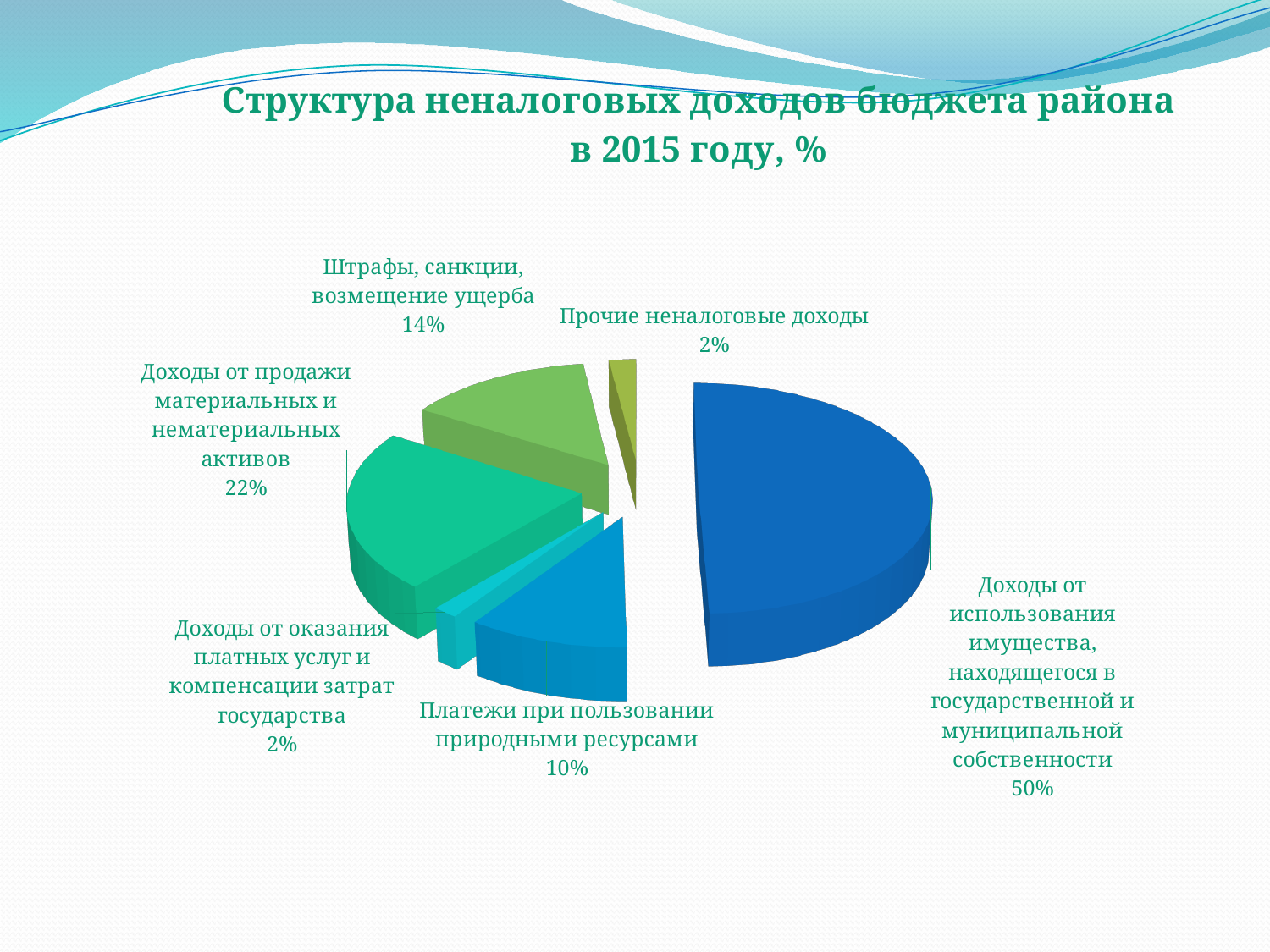
What kind of chart is shown on the slide? Pie chart What share of the pie is labelled "Доходы от использования имущества, находящегося в государственной и муниципальной собственности"? 50% What is the difference between the shares of "Доходы от продажи материальных и нематериальных активов" and "Штрафы, санкции, возмещение ущерба"? 8% What is the title of the chart on the slide? Структура неналоговых доходов бюджета района в 2015 году, % What is the value shown for "Прочие неналоговые доходы"? 2% What is the difference between the largest slice and "Платежи при пользовании природными ресурсами"? 40% What is the value shown for "Доходы от продажи материальных и нематериальных активов"? 22% What is the value shown for "Платежи при пользовании природными ресурсами"? 10% Which category has the largest slice of the pie? Доходы от использования имущества, находящегося в государственной и муниципальной собственности What is the value shown for "Штрафы, санкции, возмещение ущерба"? 14% Which is larger: "Платежи при пользовании природными ресурсами" or "Штрафы, санкции, возмещение ущерба"? Штрафы, санкции, возмещение ущерба How many slices does the pie chart have? 6